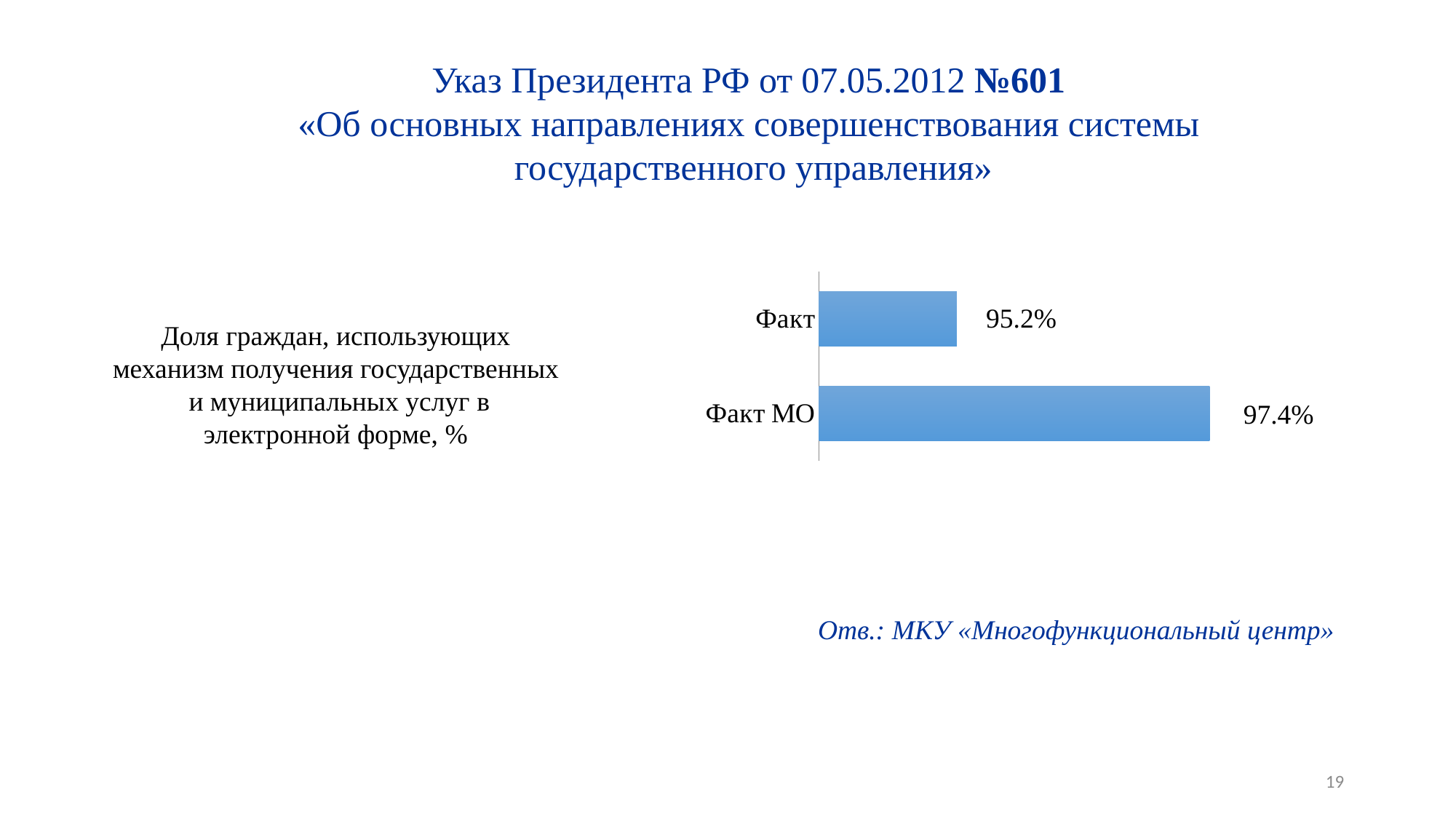
What is the difference between the values for Факт МО and Факт? 2.2% Which category has the lowest value? Факт What is the value for Факт МО? 97.4% Which category has the highest value? Факт МО How many categories are shown in the chart? 2 What is the value for Факт? 95.2% What indicator does the chart describe, according to the text to its left? Доля граждан, использующих механизм получения государственных и муниципальных услуг в электронной форме, % What kind of chart is shown on the slide? bar chart Which is larger, the value for Факт or the value for Факт МО? Факт МО What colour are the bars in the chart? blue